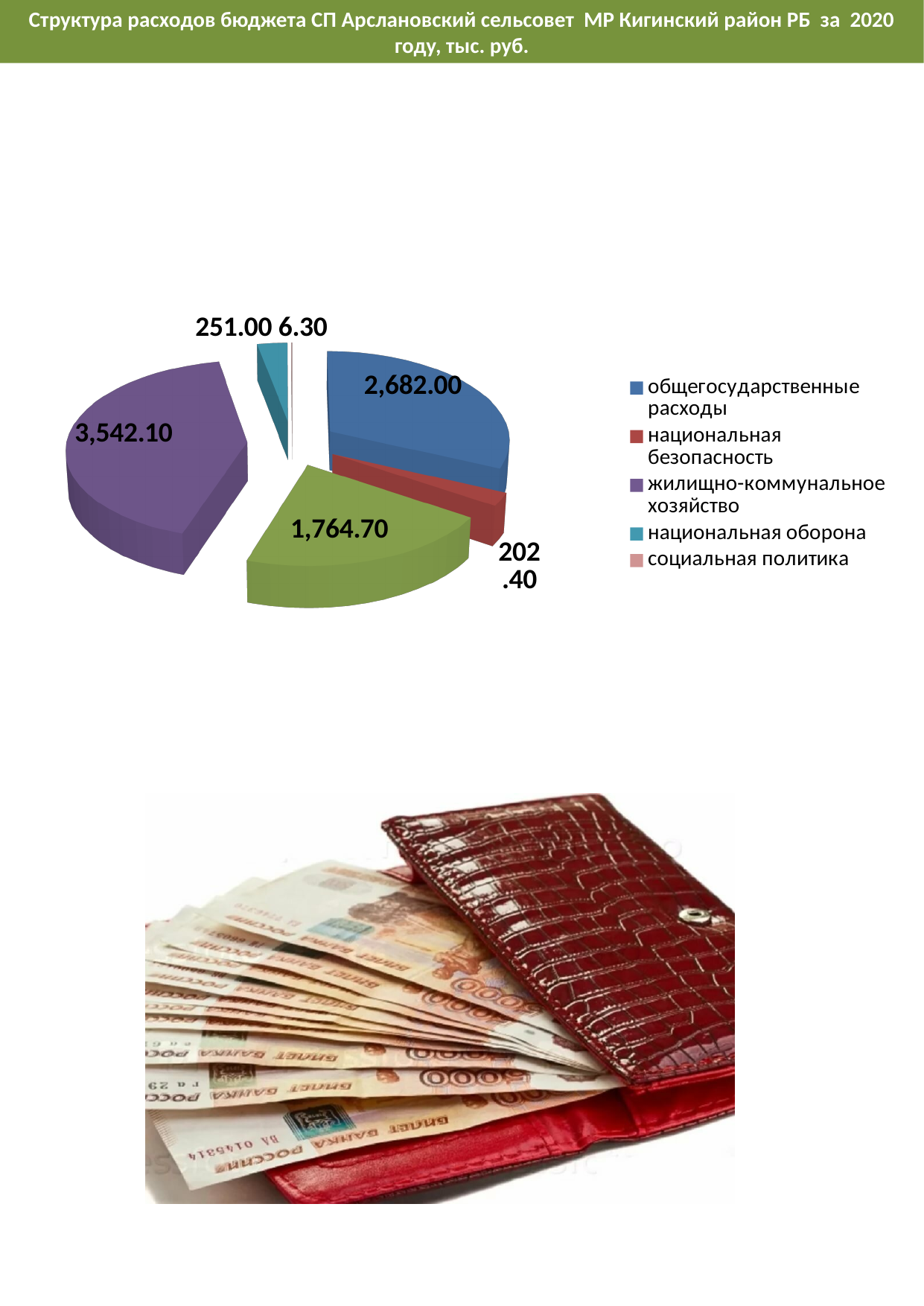
Which category has the largest slice of the pie? жилищно-коммунальное хозяйство What is the value for жилищно-коммунальное хозяйство? 3,542.10 What is the value for общегосударственные расходы? 2,682.00 What is the value for социальная политика? 6.30 What type of chart is shown on the slide? pie chart How many entries does the legend list? 5 Which category has the smallest slice of the pie? социальная политика How many slices does the pie chart have? 6 What is the value for национальная безопасность? 202.40 Which is larger: национальная оборона or национальная безопасность? национальная оборона What is the value for национальная оборона? 251.00 What is the difference between the values for жилищно-коммунальное хозяйство and общегосударственные расходы? 860.10